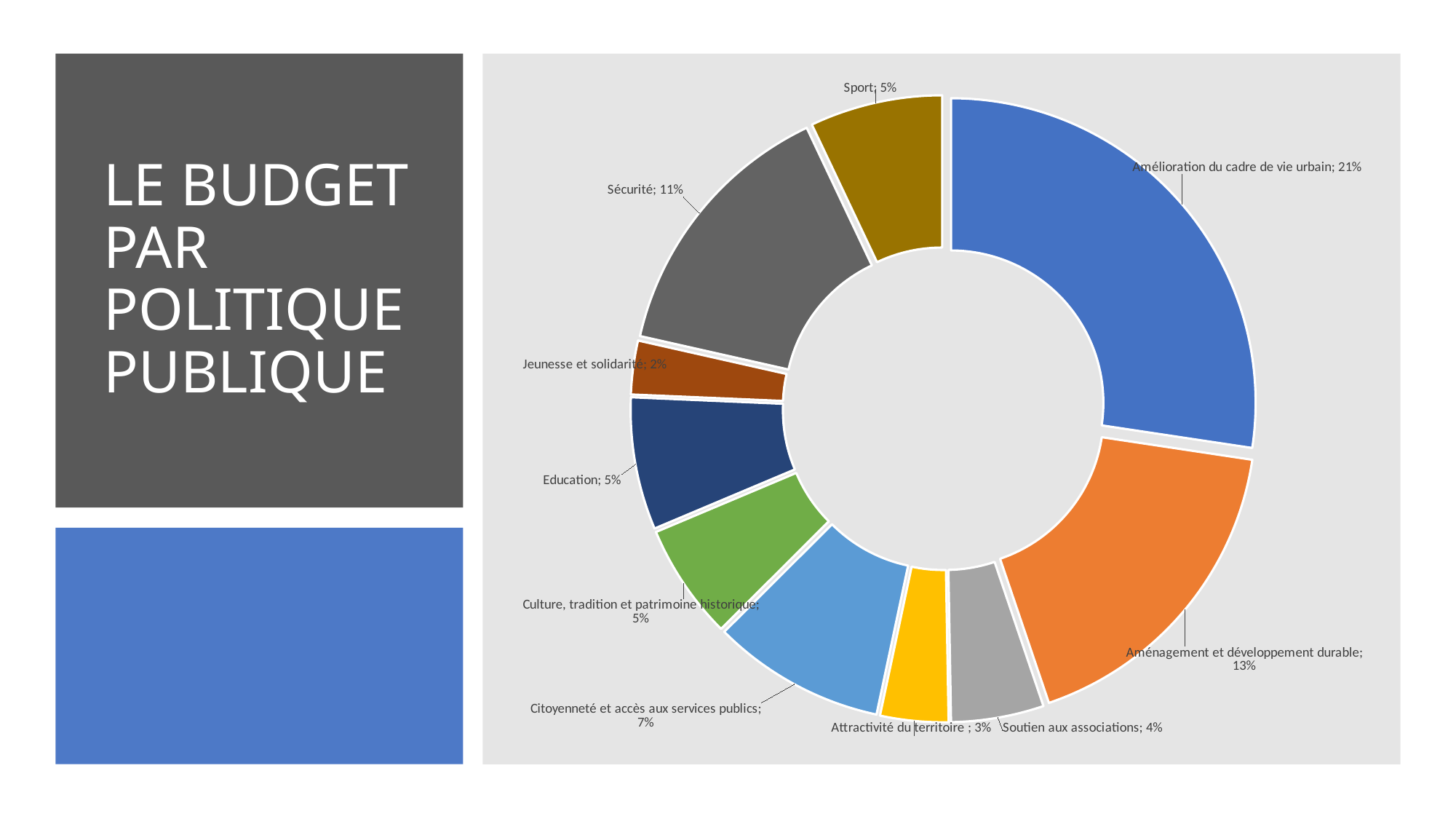
What percentage is shown for Citoyenneté et accès aux services publics? 7% What kind of chart is shown on the slide? doughnut chart Which is larger, the share for Sécurité or the share for Citoyenneté et accès aux services publics? Sécurité What is the title of the slide? LE BUDGET PAR POLITIQUE PUBLIQUE What percentage is shown for Sécurité? 11% How many categories are shown in the chart? 10 Which category has the smallest share of the budget? Jeunesse et solidarité What percentage is shown for Jeunesse et solidarité? 2% Which category has the largest share of the budget? Amélioration du cadre de vie urbain What percentage is shown for Amélioration du cadre de vie urbain? 21% What percentage is shown for Aménagement et développement durable? 13% What is the difference in percentage points between Amélioration du cadre de vie urbain and Aménagement et développement durable? 8